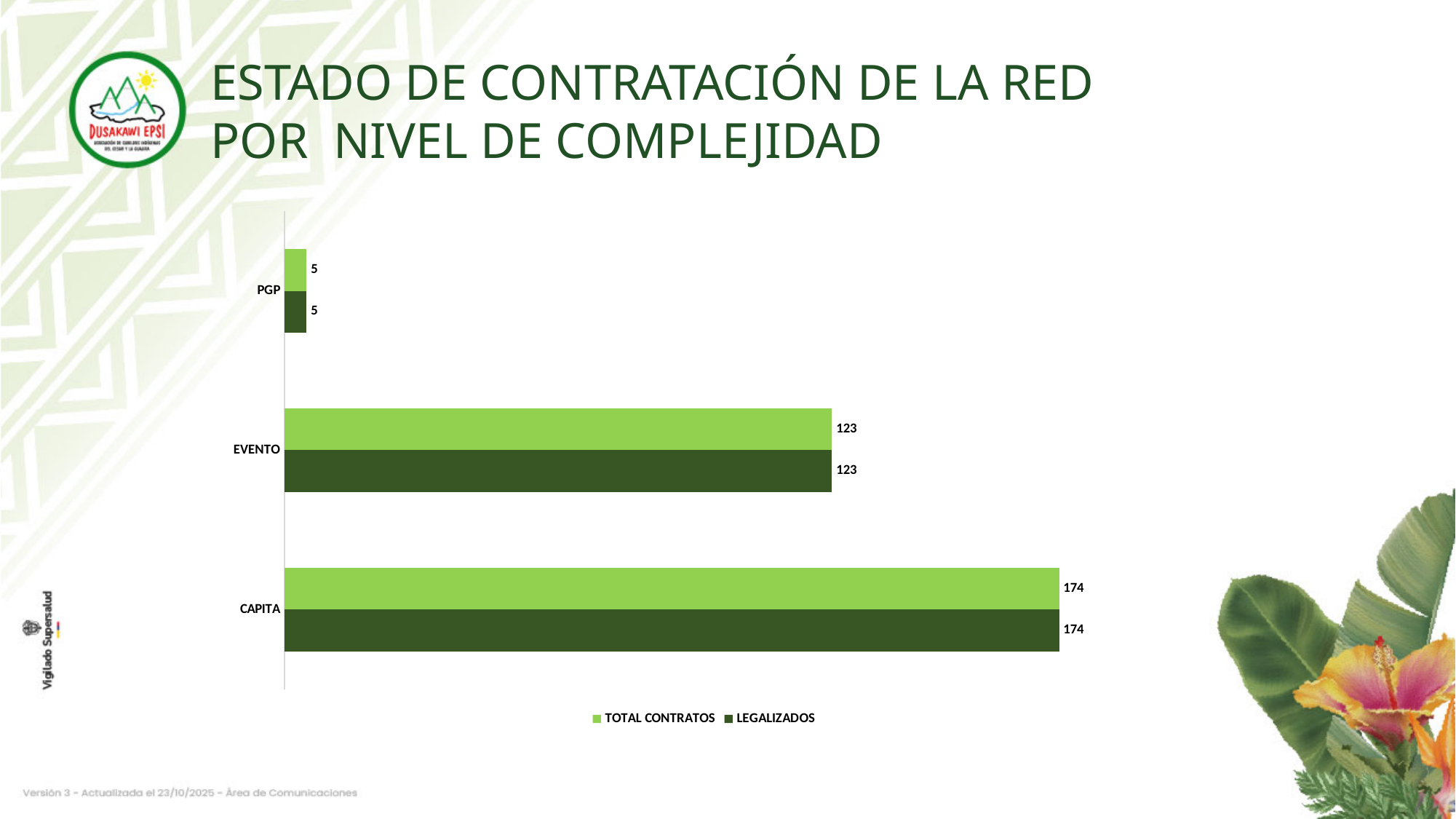
How many series does the legend list? 2 What is the LEGALIZADOS value for EVENTO? 123 Which category has the highest TOTAL CONTRATOS value? CAPITA What is the TOTAL CONTRATOS value for CAPITA? 174 What kind of chart is shown on the slide? Bar chart How many categories are shown on the chart? 3 Which category has the lowest LEGALIZADOS value? PGP What is the difference between the LEGALIZADOS values for EVENTO and PGP? 118 What is the TOTAL CONTRATOS value for PGP? 5 Which series is shown in dark green in the legend? LEGALIZADOS Which is larger: the TOTAL CONTRATOS value for EVENTO or for PGP? EVENTO What is the difference between the TOTAL CONTRATOS values for CAPITA and EVENTO? 51